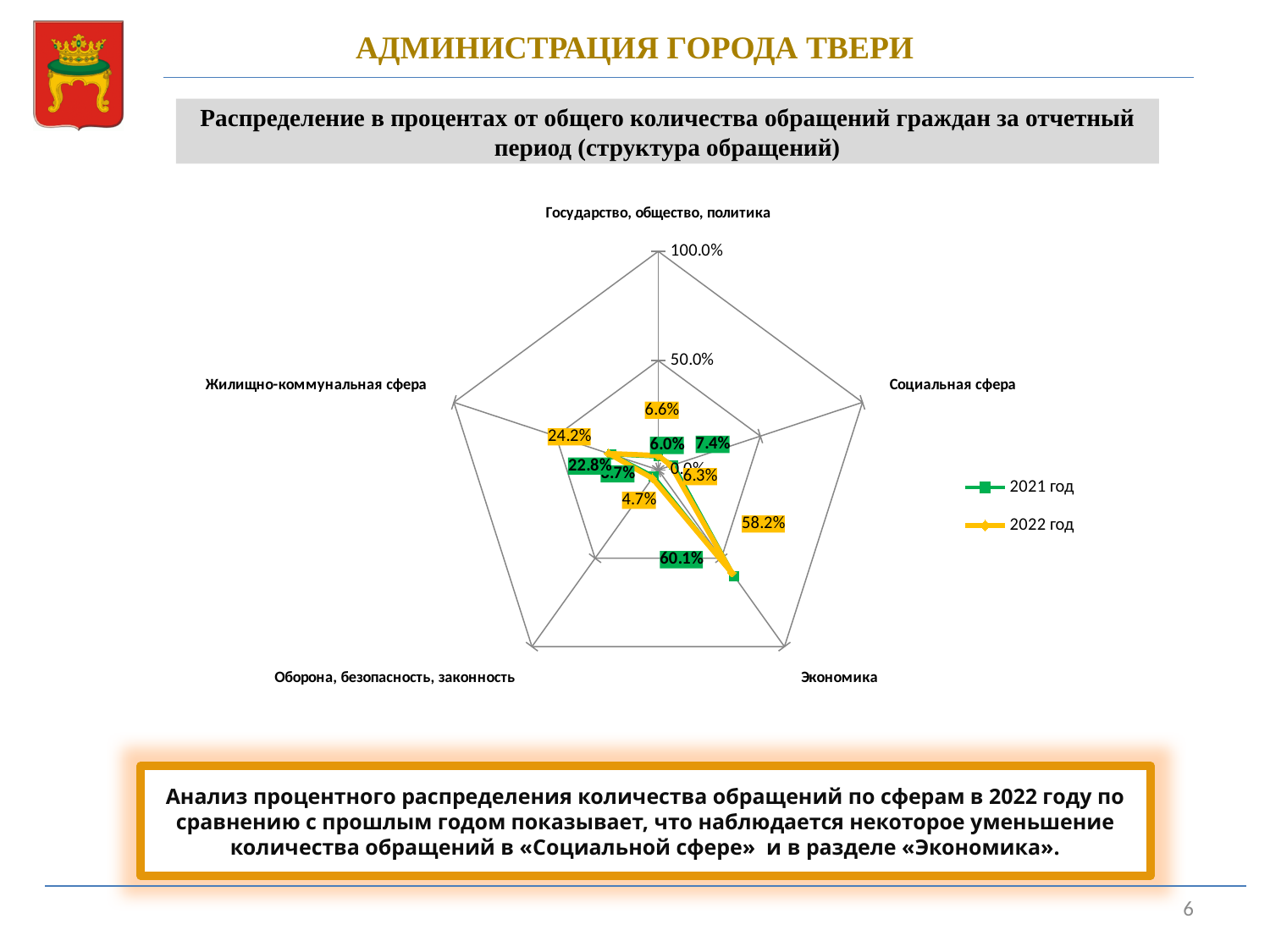
What are the two entries listed in the chart legend? 2021 год and 2022 год What is the value for Экономика in the 2022 год series? 58.2% By how many percentage points did the value for Экономика fall from 2021 год to 2022 год? 1.9 What is the value for Государство, общество, политика in the 2022 год series? 6.6% What kind of chart is shown on the slide? Radar chart How many series does the chart legend list? 2 How many categories (axes) does the radar chart have? 5 What is the value for Жилищно-коммунальная сфера in the 2021 год series? 22.8% Which category has the highest value in the 2022 год series? Экономика For Социальная сфера, which series has the larger value, 2021 год or 2022 год? 2021 год What is the value for Экономика in the 2021 год series? 60.1% What is the value for Жилищно-коммунальная сфера in the 2022 год series? 24.2%